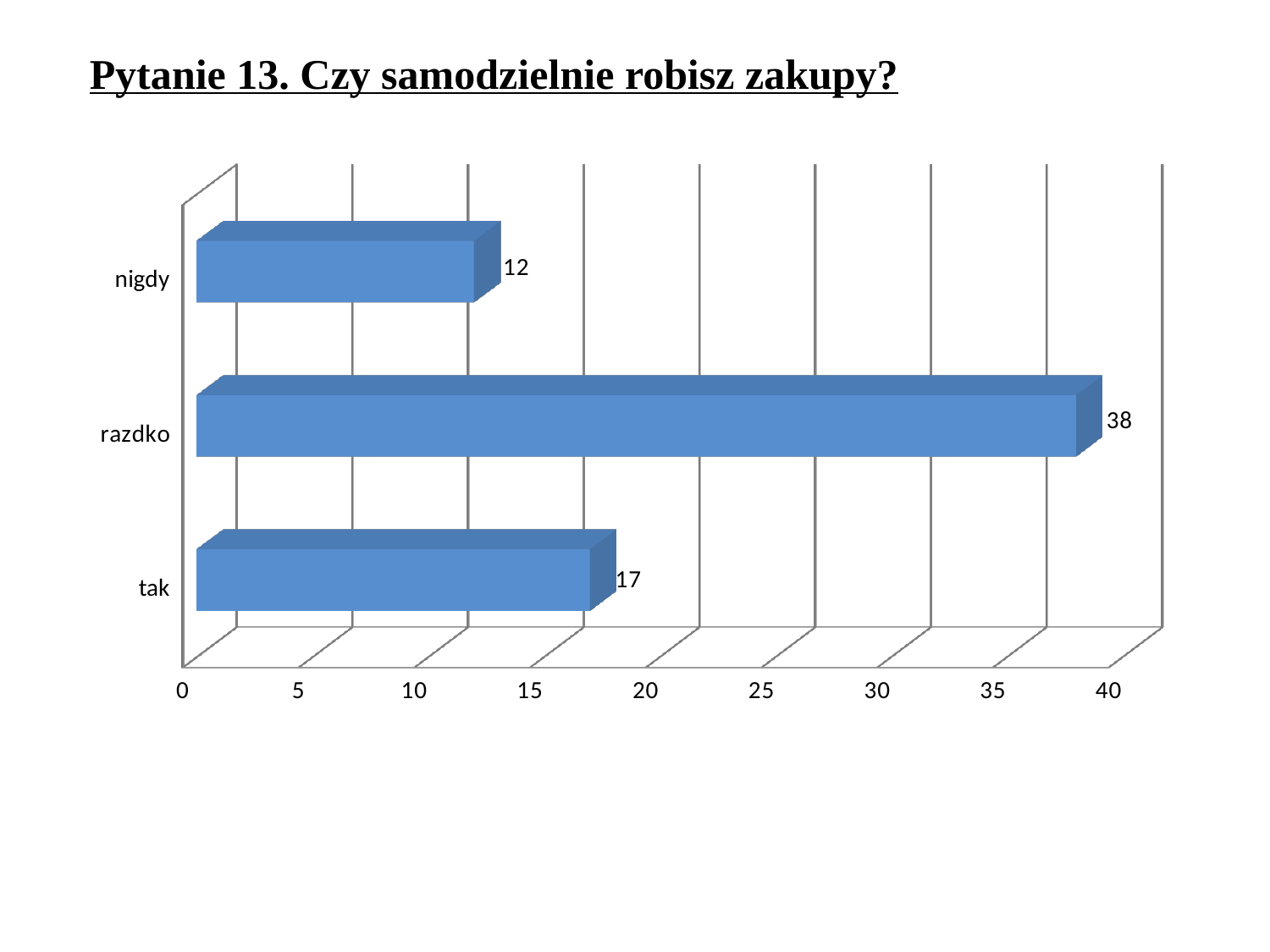
What kind of chart is shown on the slide? bar chart Which category has the lowest value? nigdy What is the value for "nigdy"? 12 What is the value for "razdko"? 38 What is the value for "tak"? 17 Is the value for "razdko" greater or less than 35? greater Which is larger, the value for "tak" or the value for "nigdy"? tak What is the difference between the values for "tak" and "nigdy"? 5 Which category has the highest value? razdko What is the title of the slide? Pytanie 13. Czy samodzielnie robisz zakupy? What is the difference between the values for "razdko" and "tak"? 21 How many categories are shown in the chart? 3